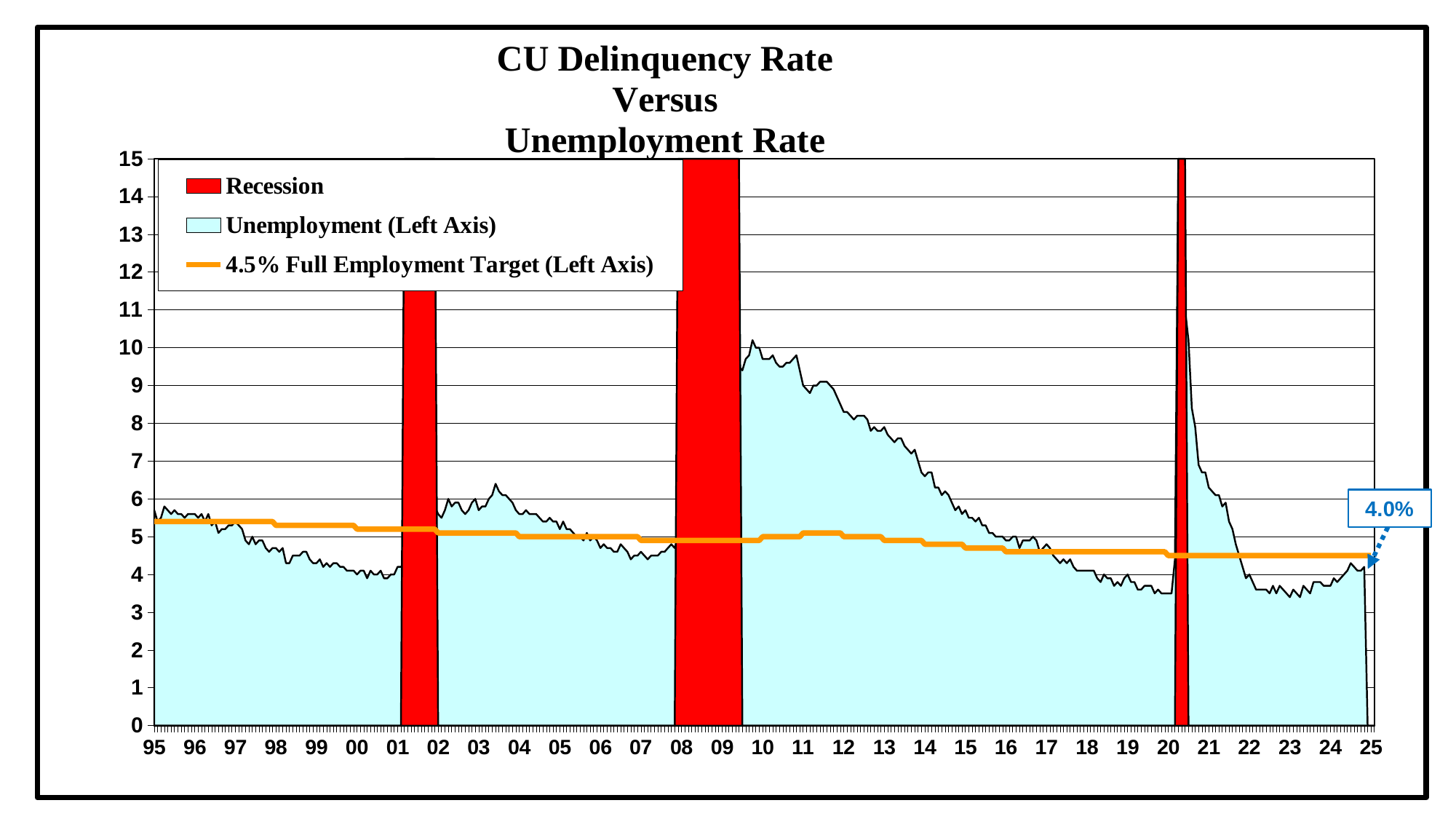
What kind of chart is used to show the unemployment series? area chart Is the peak unemployment rate in 2020 greater or less than 10? greater Is the unemployment rate in 2000 greater or less than 5? less How many recession periods are shaded on the chart? 3 In which year does the unemployment rate reach its highest peak? 2020 Is the unemployment rate in 2010 greater or less than 8? greater Which year has the higher unemployment rate, 2003 or 2010? 2010 Does the unemployment rate rise or fall from 2010 to 2019? fall What is the title of the chart? CU Delinquency Rate Versus Unemployment Rate What unemployment rate value is labeled at the end of the series in 2025? 4.0% How many entries does the chart's legend list? 3